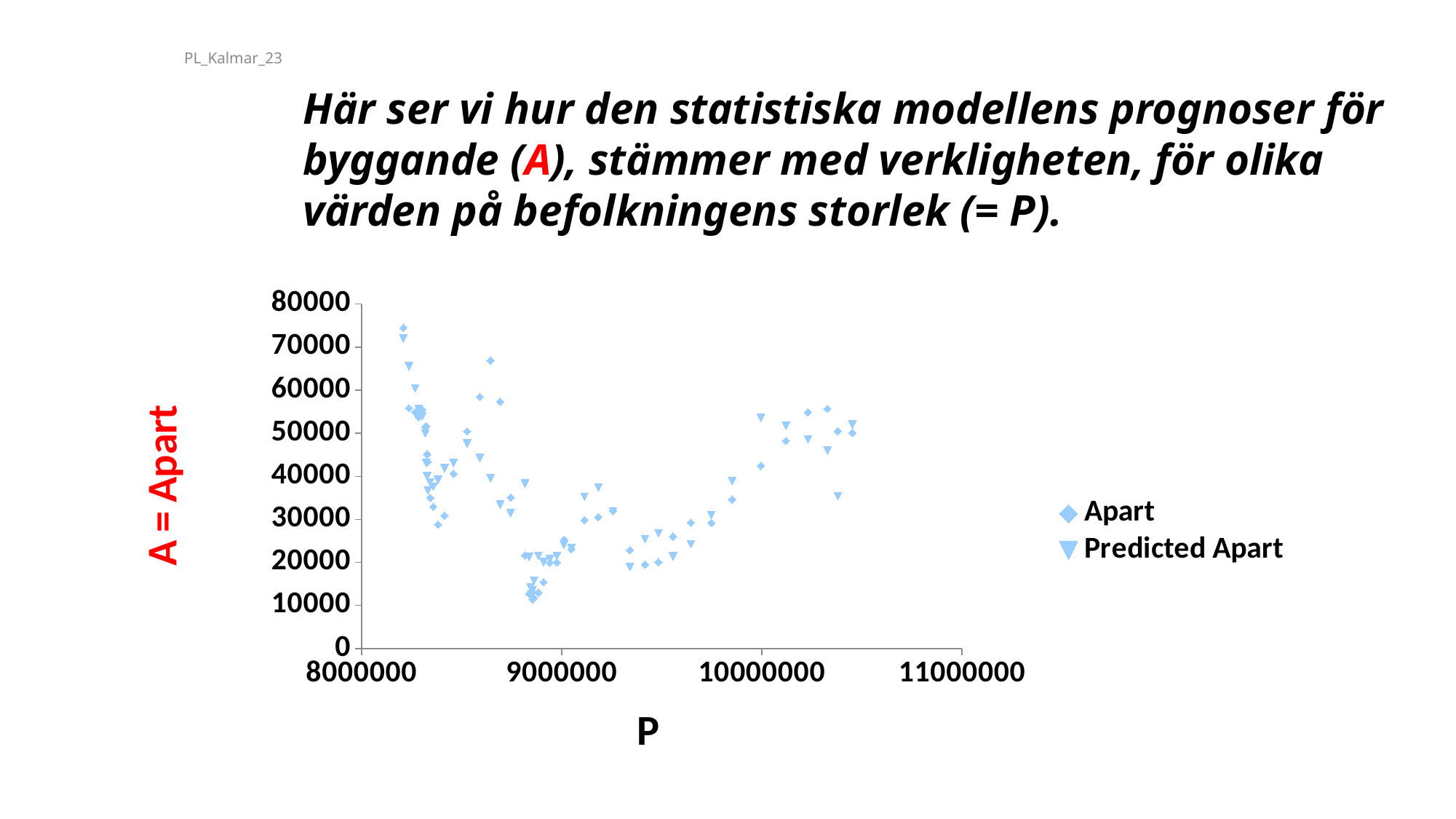
What is the label on the vertical axis? A = Apart Is the highest Apart value greater or less than 70000? greater Are any plotted values greater or less than 80000? less Are the Apart values near P = 9000000 greater or less than 30000? less What are the two series named in the legend? Apart and Predicted Apart How many series does the legend list? 2 What kind of chart is shown on the slide? scatter chart Do the Apart values generally rise or fall as P increases from 9000000 to 10000000? rise Do the Apart values generally rise or fall as P increases from 8000000 to 9000000? fall